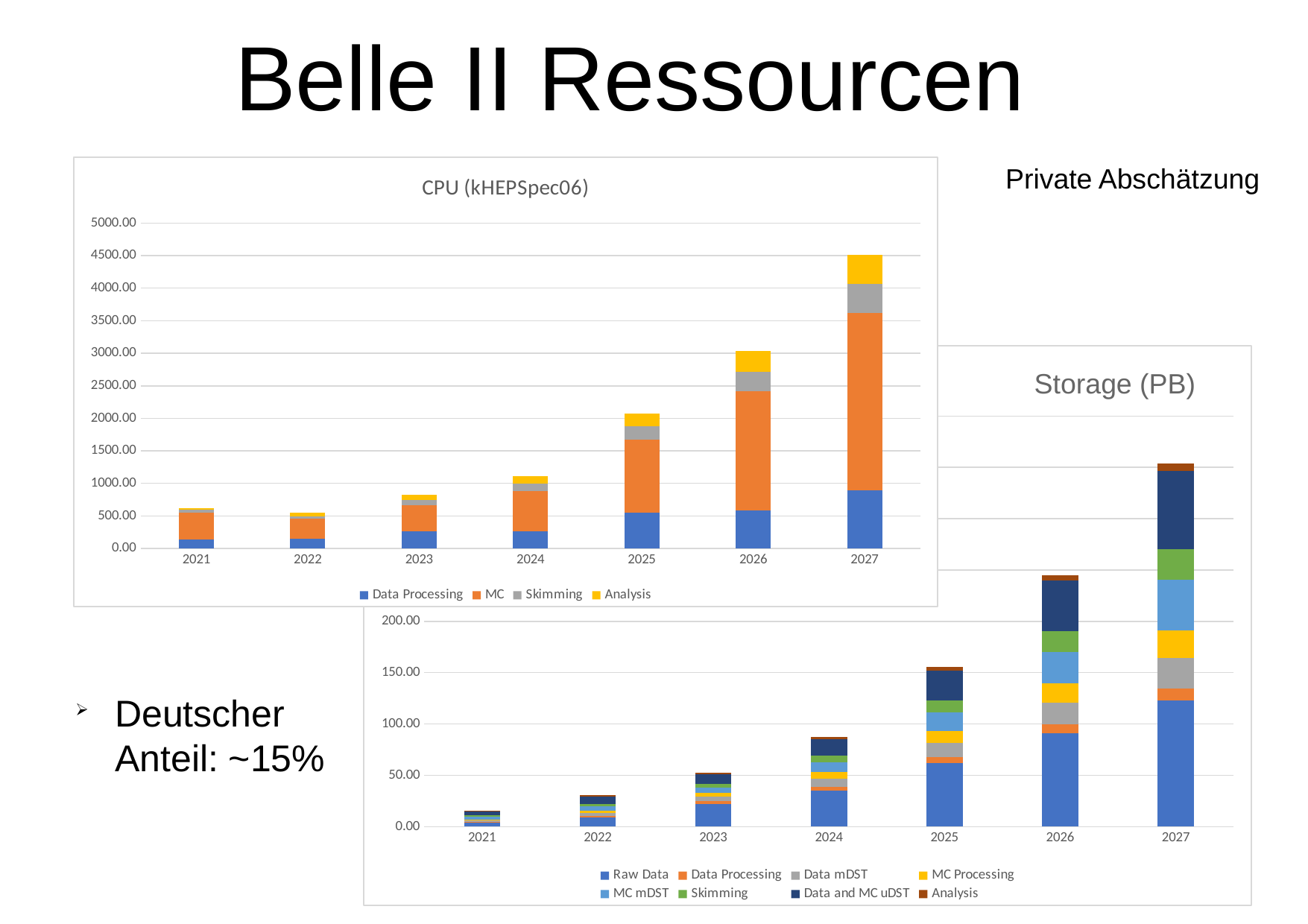
In the Storage (PB) chart, which year has the lowest total? 2021 How many years are shown on the x axis of the Storage (PB) chart? 7 How many series does the legend of the CPU (kHEPSpec06) chart list? 4 In the Storage (PB) chart, do the totals rise or fall from 2021 to 2027? rise Which series is shown in orange in the CPU (kHEPSpec06) chart? MC In the Storage (PB) chart, is the total for 2024 greater or less than 100? less How many series does the legend of the Storage (PB) chart list? 8 In the CPU (kHEPSpec06) chart, which year has the highest total? 2027 In the CPU (kHEPSpec06) chart, is the total for 2023 greater or less than 1000? less In the CPU (kHEPSpec06) chart, is the total for 2027 greater or less than 4000? greater What kind of chart is the CPU (kHEPSpec06) chart? stacked bar chart